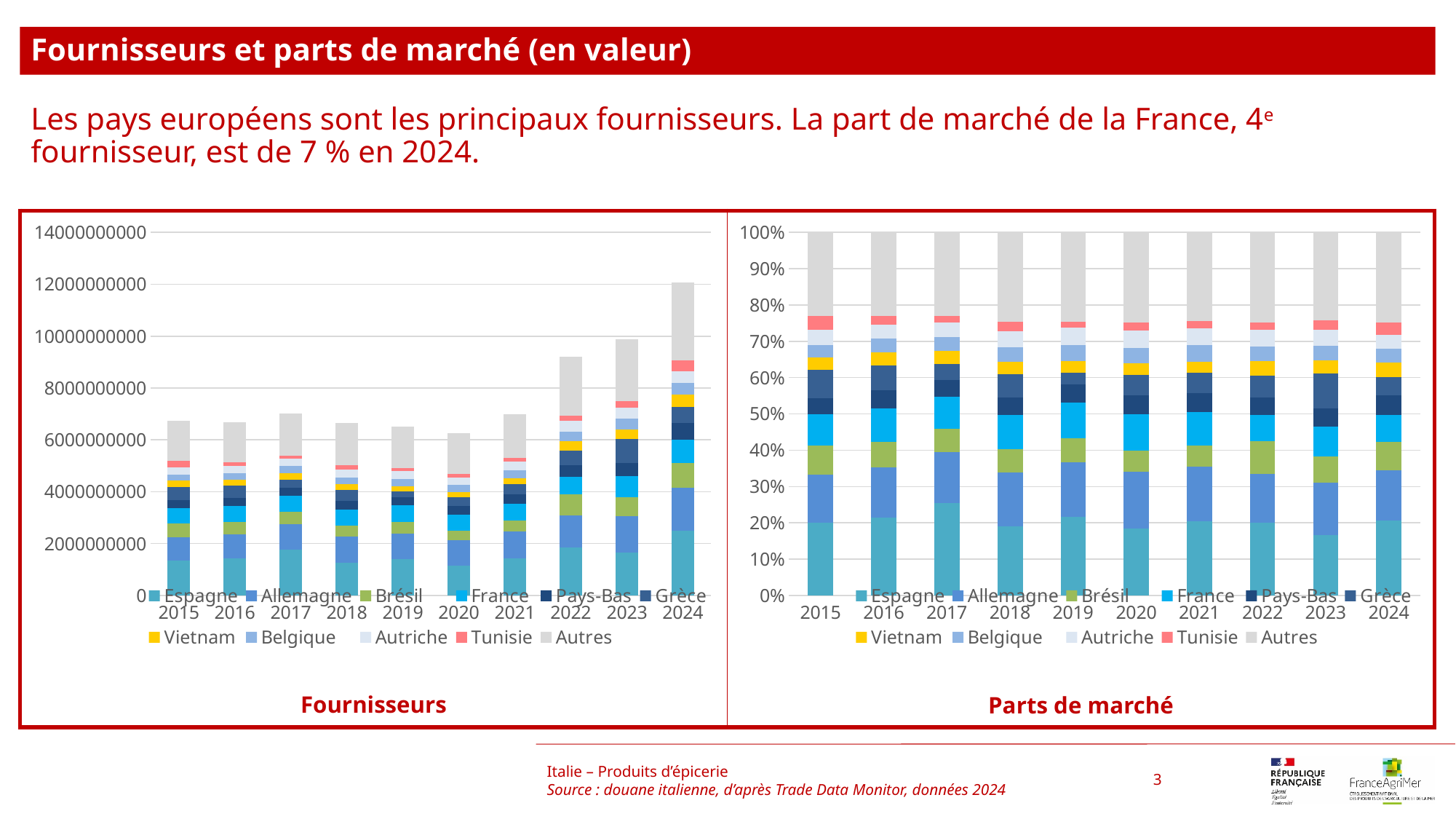
How many years are shown on the x axis of the 'Parts de marché' chart? 10 In the 'Fournisseurs' chart, is the total bar for 2024 greater or less than 10000000000? greater In the 'Fournisseurs' chart, do the total bars rise or fall from 2021 to 2024? rise Which series is shown in grey at the top of each bar in both charts? Autres In the 'Fournisseurs' chart, is the total bar for 2020 greater or less than 8000000000? less In the 'Fournisseurs' chart, which year has the lowest total bar? 2020 What is the title shown under the right-hand chart? Parts de marché In the 'Fournisseurs' chart, which year has the highest total bar? 2024 How many series does the legend of the 'Fournisseurs' chart list? 11 In the 'Fournisseurs' chart, which total bar is larger, 2015 or 2023? 2023 What kind of chart is the 'Fournisseurs' chart on the left? stacked bar chart